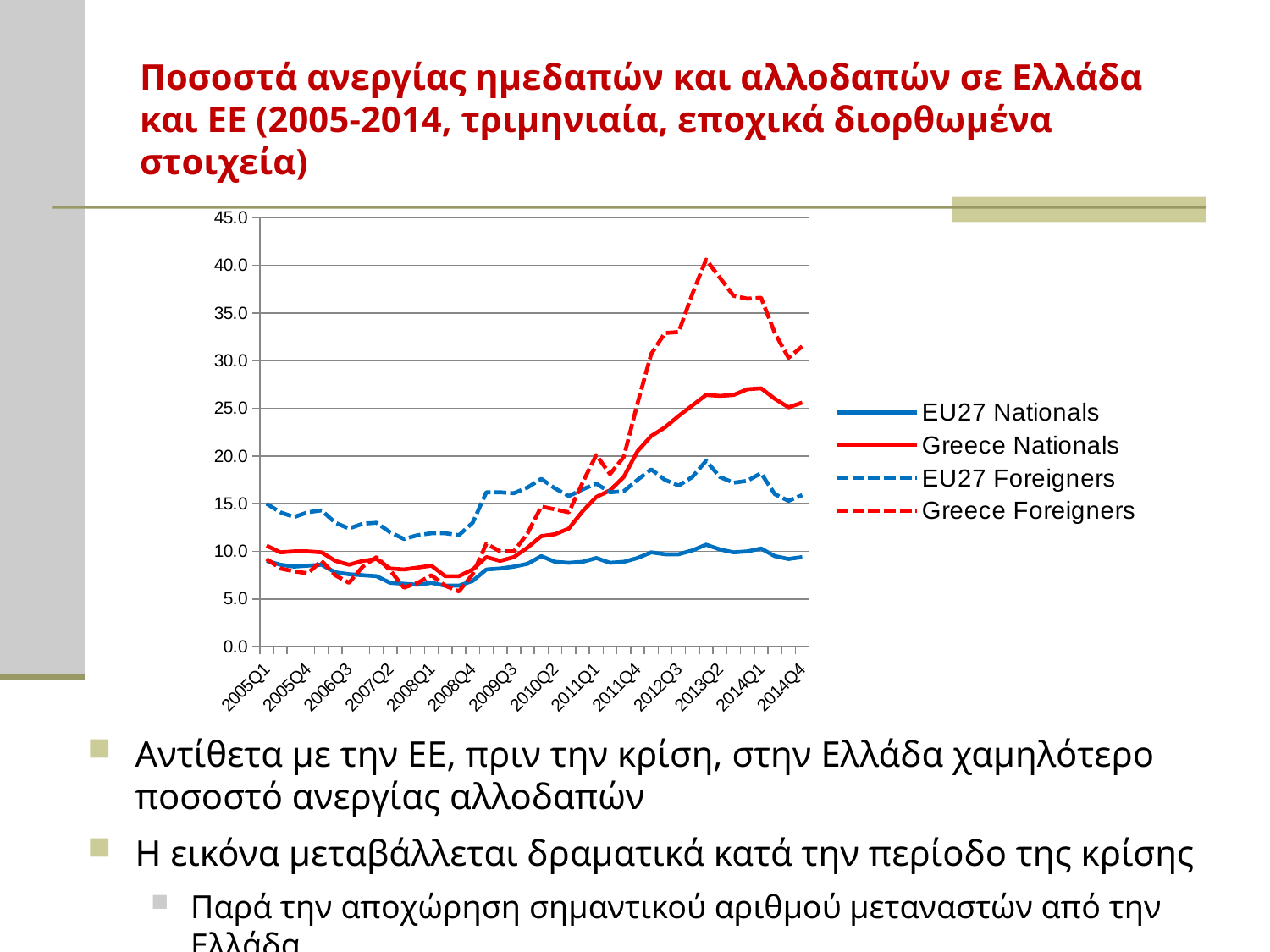
Is the value for EU27 Foreigners at 2013Q2 greater or less than 15? greater Which series is drawn as a dashed red line? Greece Foreigners At 2005Q1, which is larger: EU27 Foreigners or Greece Foreigners? EU27 Foreigners Which series has the lowest value at 2014Q4? EU27 Nationals Is the value for Greece Foreigners at 2013Q2 greater or less than 35? greater How many series does the chart's legend list? 4 What kind of chart is shown on the slide? line chart Is the value for Greece Nationals at 2013Q2 greater or less than 20? greater Does the Greece Nationals line rise or fall between 2009Q3 and 2013Q2? rise Which series reaches the highest value anywhere on the chart? Greece Foreigners At 2014Q4, which is larger: Greece Nationals or EU27 Nationals? Greece Nationals